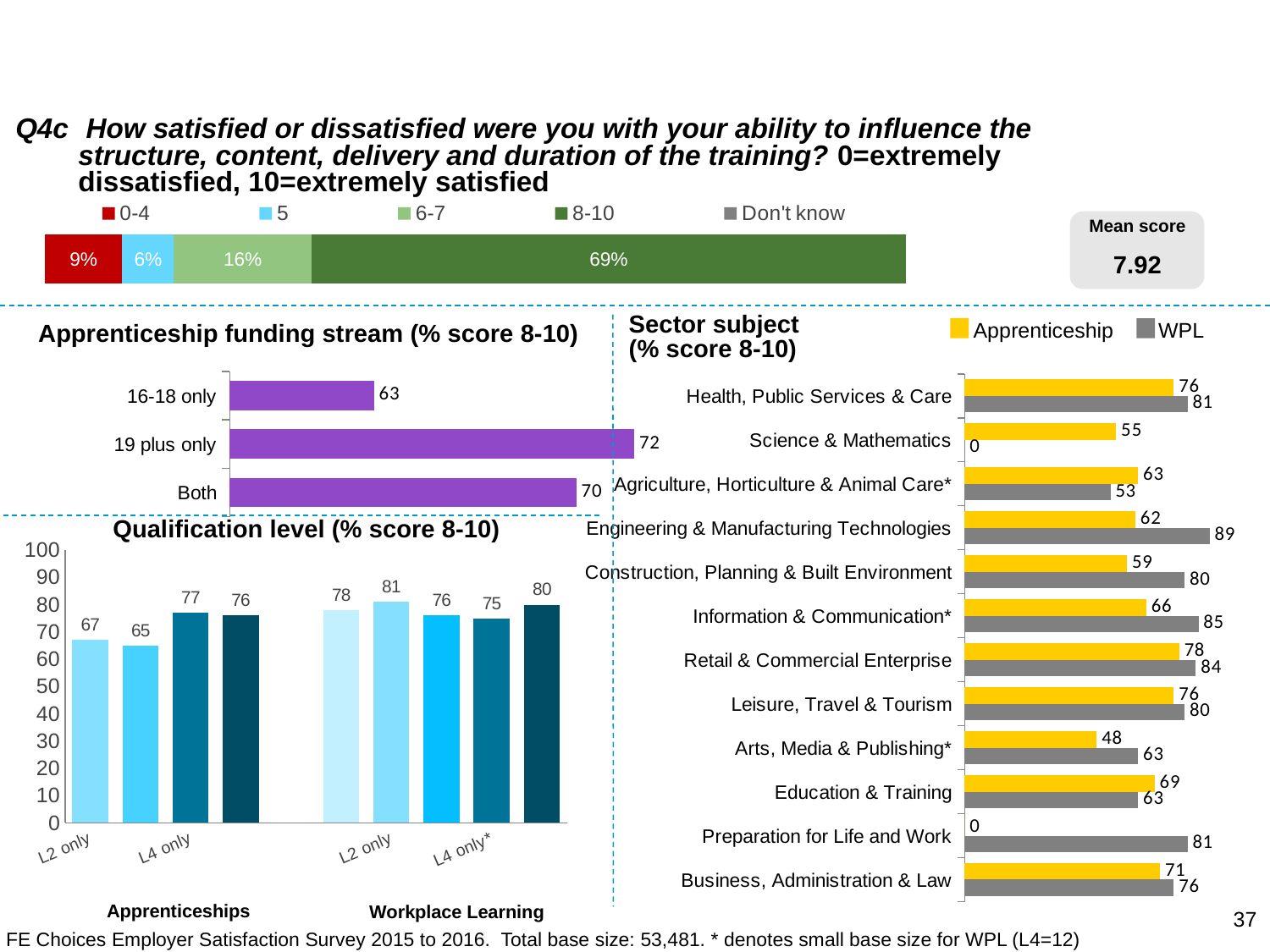
In the 'Apprenticeship funding stream (% score 8-10)' chart, what is the value for '19 plus only'? 72 In the top stacked bar showing the distribution of scores, what percentage of respondents gave a score of 8-10? 69% In the 'Sector subject (% score 8-10)' chart, what is the difference between the WPL and Apprenticeship values for 'Construction, Planning & Built Environment'? 21 In the 'Sector subject (% score 8-10)' chart, what is the WPL value for 'Engineering & Manufacturing Technologies'? 89 In the 'Qualification level (% score 8-10)' chart, how many bars are plotted? 9 How many series does the legend of the 'Sector subject (% score 8-10)' chart list? 2 In the 'Apprenticeship funding stream (% score 8-10)' chart, what is the difference between '19 plus only' and 'Both'? 2 In the 'Qualification level (% score 8-10)' chart, what is the highest value shown on any bar? 81 In the 'Sector subject (% score 8-10)' chart, which is larger for 'Education & Training': the Apprenticeship value or the WPL value? Apprenticeship In the 'Sector subject (% score 8-10)' chart, what is the Apprenticeship value for 'Arts, Media & Publishing*'? 48 What is the mean score shown on the slide for Q4c? 7.92 In the 'Apprenticeship funding stream (% score 8-10)' chart, which category has the lowest value? 16-18 only